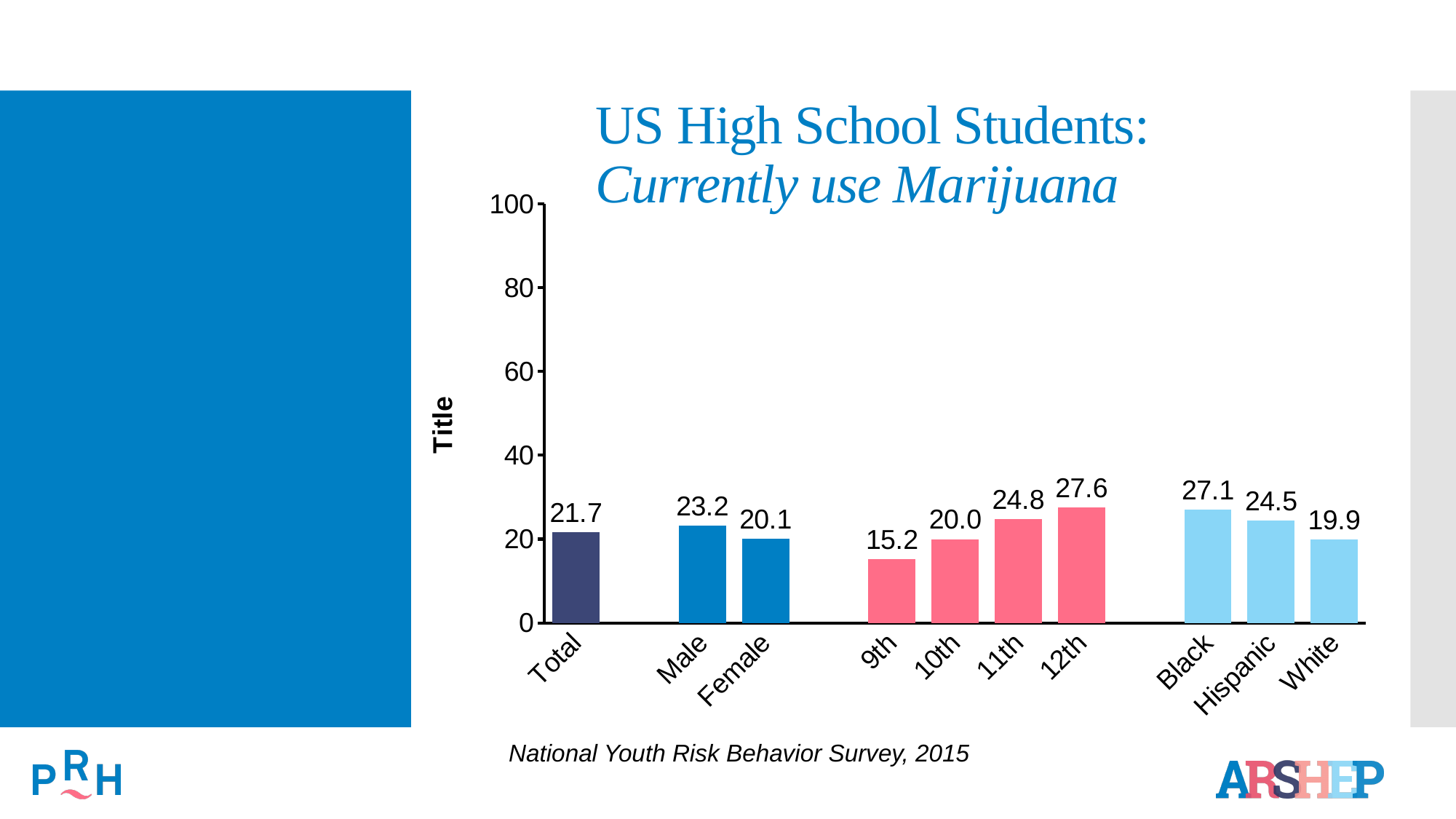
What is the value for Female? 20.1 What is the difference between the Male and Female values? 3.1 Which category has the highest value? 12th Which category has the lowest value? 9th How many categories are shown on the x axis? 10 What is the value for 9th grade? 15.2 Is the value for 12th grade greater or less than 20? greater What is the value for Total? 21.7 Which is larger, the value for Black or the value for White? Black What is the value for Hispanic? 24.5 What kind of chart is shown? bar chart Do the values rise or fall from 9th grade to 12th grade? rise